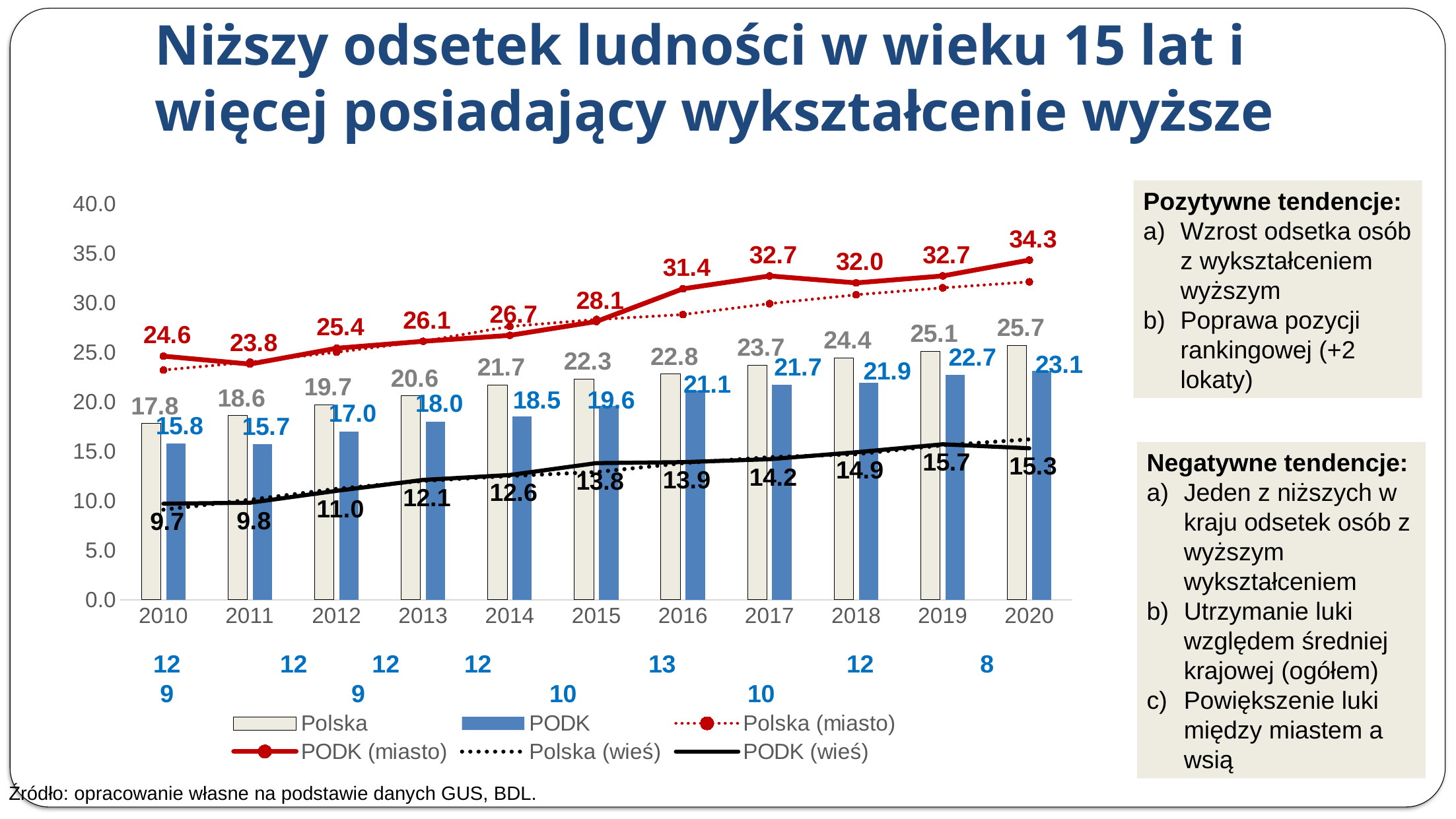
How many years are shown on the x axis? 11 Which is larger in 2019: the PODK (miasto) value or the Polska value? PODK (miasto) In which year is the PODK (miasto) value highest? 2020 In which year is the PODK value lowest? 2011 How many series does the legend list? 6 What is the value for Polska in 2020? 25.7 What is the value for PODK (miasto) in 2016? 31.4 What is the value for PODK (wieś) in 2013? 12.1 What is the difference between the Polska and PODK values in 2010? 2.0 Is the value for Polska (miasto) in 2020 greater or less than 30.0? greater What is the value for PODK in 2015? 19.6 Does the PODK (wieś) series generally rise or fall from 2010 to 2019? rise